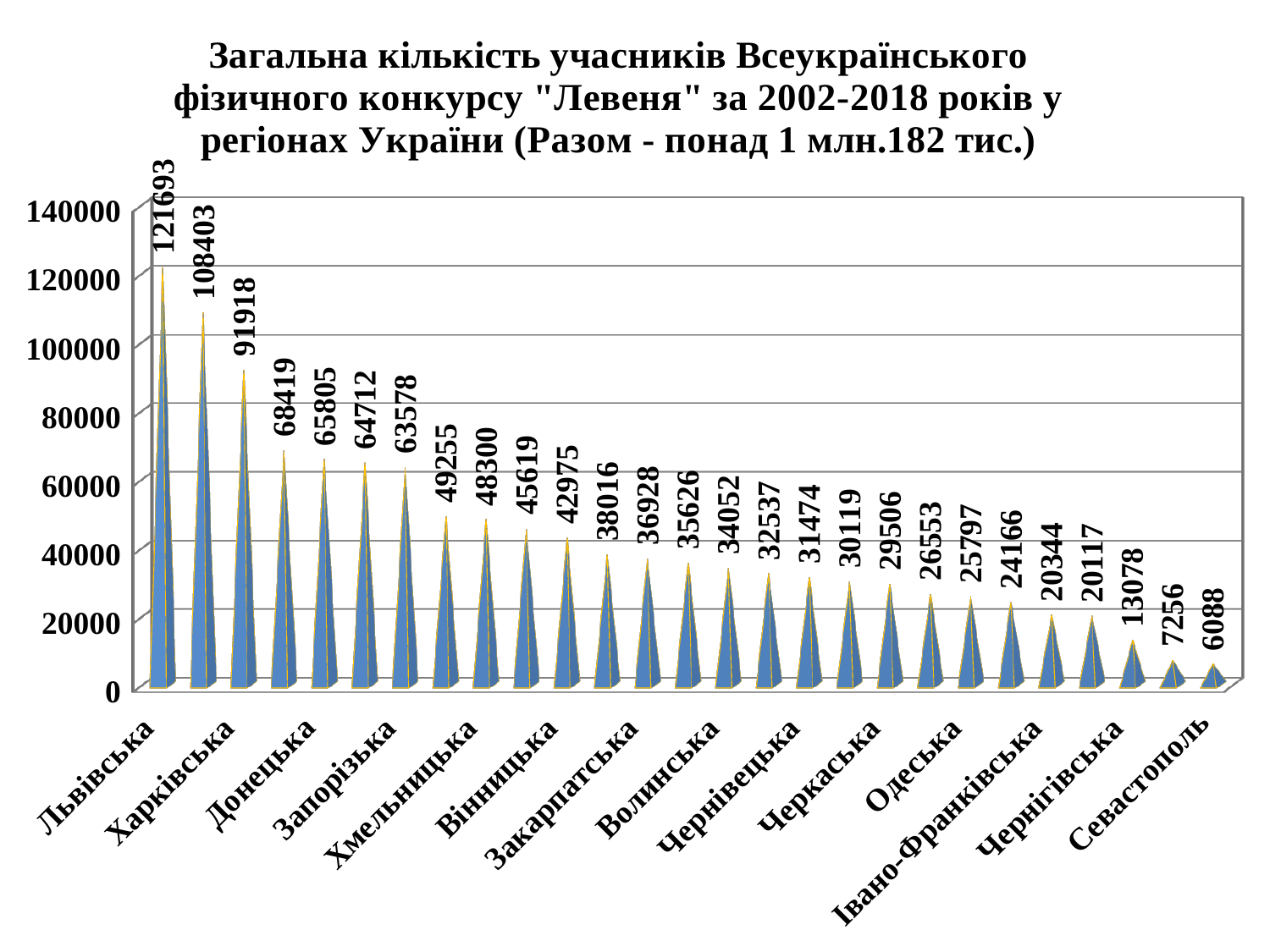
Which region has the lowest number of participants? Севастополь According to the chart title, what is the total number of participants for 2002-2018? понад 1 млн.182 тис. Do the values rise or fall from left to right along the x axis? fall What is the value for Севастополь? 6088 What is the difference between the highest value (121693) and the lowest value (6088)? 115605 What is the value of the highest bar? 121693 Is the value for Львівська greater or less than 120000? greater What kind of chart is shown on the slide? bar chart How many bars are plotted in the chart? 27 What is the value of the second-highest bar? 108403 Which region has the highest number of participants? Львівська Is the value for Севастополь greater or less than 20000? less